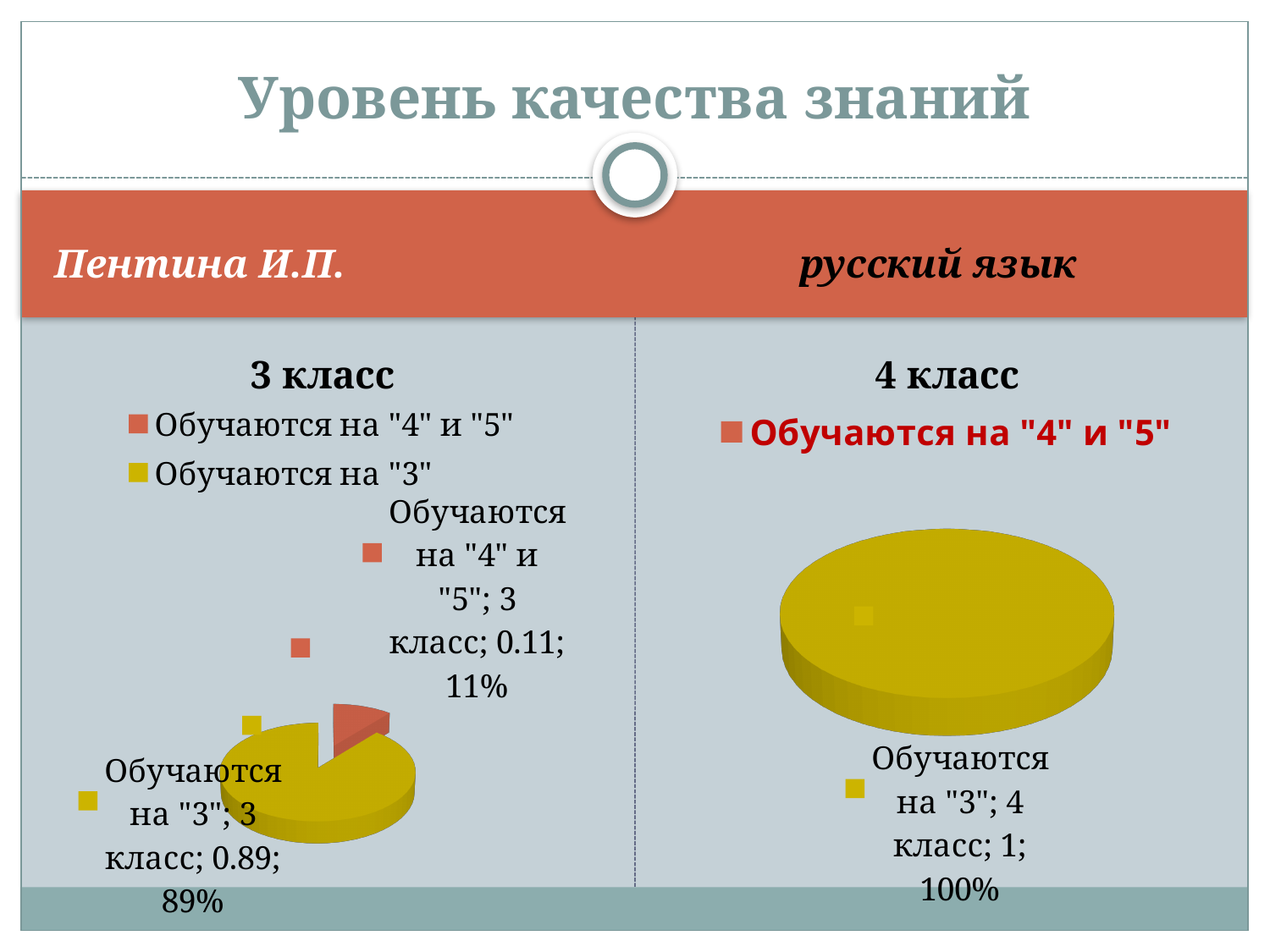
How many entries does the legend of the "3 класс" chart list? 2 In the "3 класс" chart, what is the value labelled for "Обучаются на "3""? 0.89 What colour is the "Обучаются на "3"" slice in the "3 класс" chart? yellow In the "4 класс" chart on the right, what share of the pie is "Обучаются на "3""? 100% In the "3 класс" chart, which category has the smallest slice? Обучаются на "4" и "5" In the "3 класс" chart, what is the difference in percentage points between the "Обучаются на "3"" slice and the "Обучаются на "4" и "5"" slice? 78% In the "3 класс" chart, which category has the largest slice? Обучаются на "3" In the "3 класс" chart, what share of the pie is "Обучаются на "3""? 89% In the "3 класс" chart, what is the value labelled for "Обучаются на "4" и "5""? 0.11 In the "4 класс" chart on the right, what is the value labelled for "Обучаются на "3""? 1 In the "3 класс" chart, what share of the pie is "Обучаются на "4" и "5""? 11% What kind of chart is the "3 класс" chart on the left? pie chart